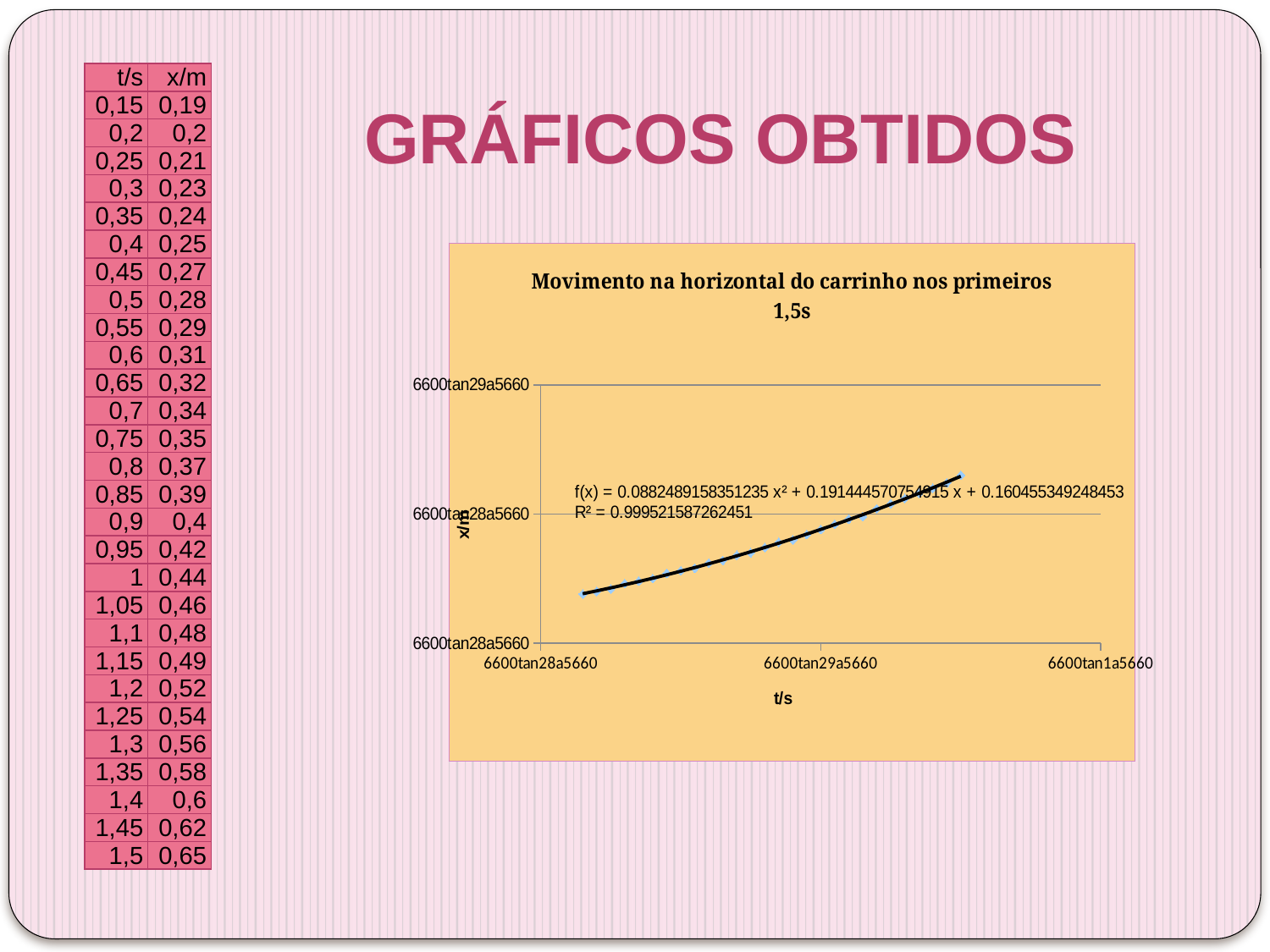
What kind of chart is shown on the slide? Scatter chart with a trendline What R² value is printed on the chart for the trendline? 0.999521587262451 Do the plotted values rise or fall as t/s increases along the x axis? Rise What is the title of the chart? Movimento na horizontal do carrinho nos primeiros 1,5s